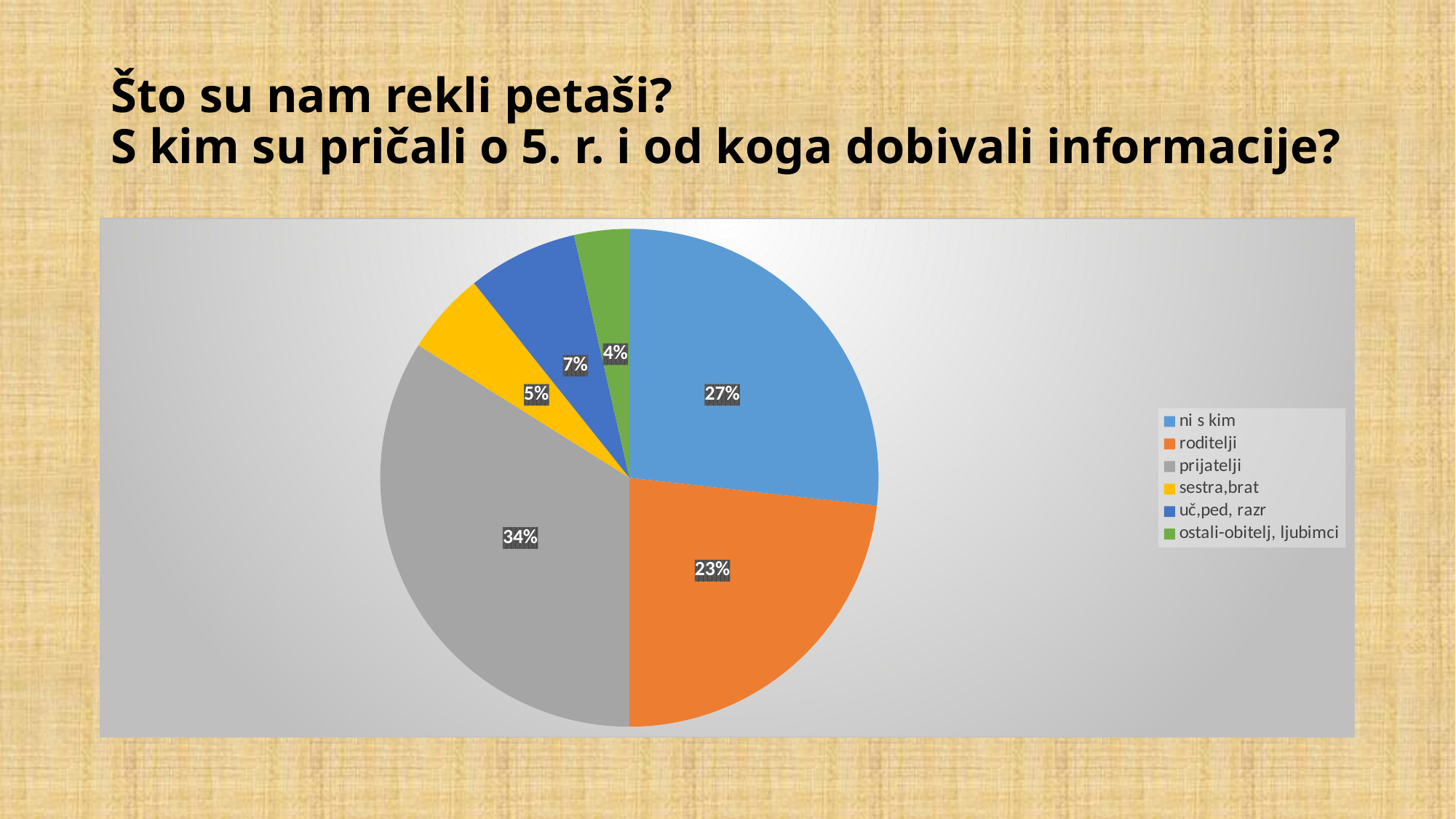
What share of the pie does "ni s kim" have? 27% What share of the pie does "uč,ped, razr" have? 7% What share of the pie does "ostali-obitelj, ljubimci" have? 4% What kind of chart is shown on the slide? pie chart Which category has the smallest slice of the pie? ostali-obitelj, ljubimci What is the difference in percentage points between "prijatelji" and "roditelji"? 11 Which is larger, the slice for "ni s kim" or the slice for "roditelji"? ni s kim How many categories does the legend list? 6 Which category has the largest slice of the pie? prijatelji